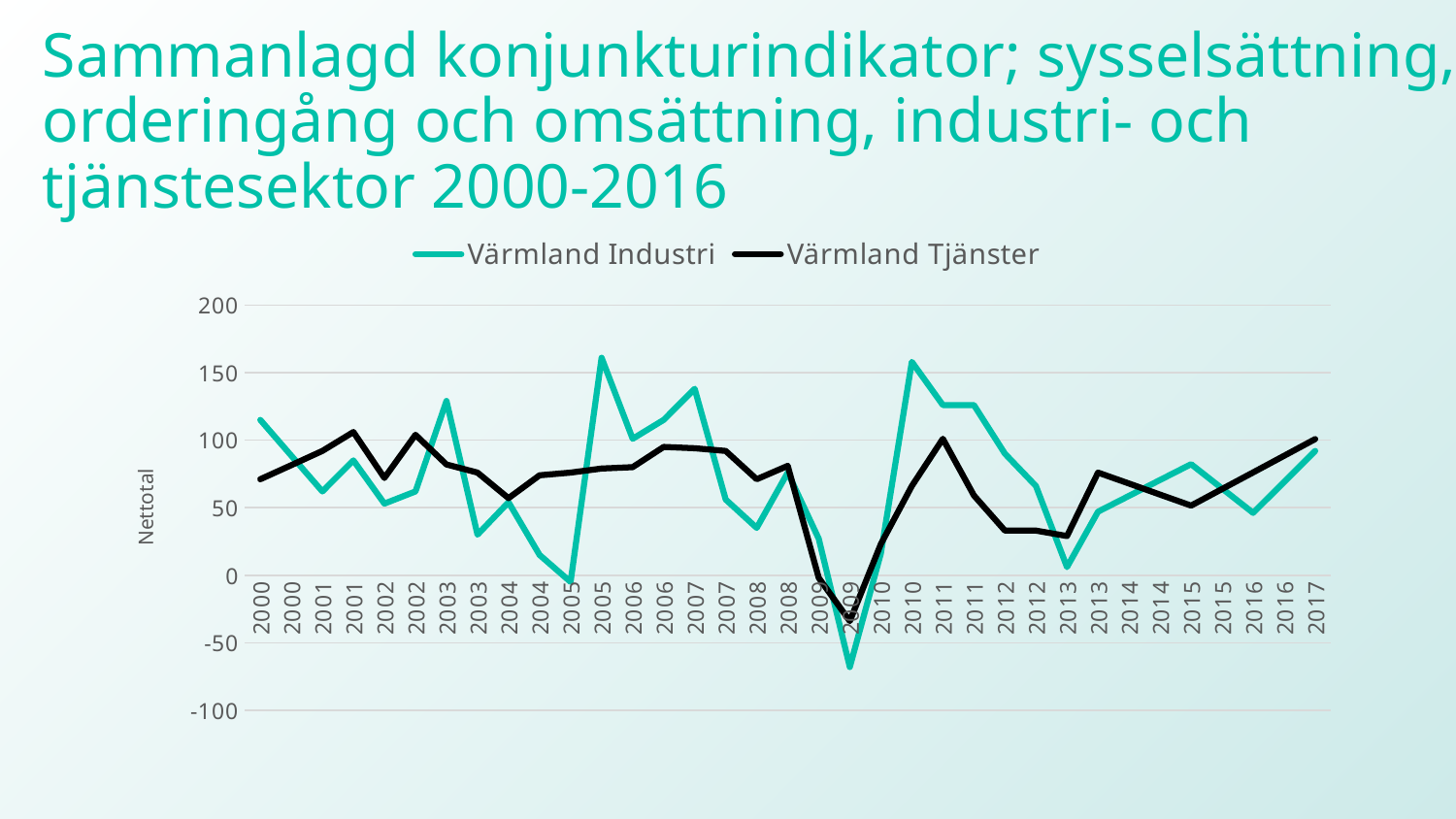
Is the value for Värmland Industri at the second 2009 point greater or less than -50? less How many series does the legend list? 2 In which year does the Värmland Industri series reach its lowest value? 2009 At the second 2004 point, which series has the higher value, Värmland Industri or Värmland Tjänster? Värmland Tjänster What are the two series named in the legend? Värmland Industri and Värmland Tjänster Does the Värmland Tjänster series rise or fall from 2015 to 2017? rise Is the value for Värmland Tjänster at the first 2012 point greater or less than 50? less Is the value for Värmland Tjänster at the second 2009 point greater or less than 0? less At the second 2010 point, which series has the higher value, Värmland Industri or Värmland Tjänster? Värmland Industri What type of chart is shown on the slide? line chart What is the label on the vertical axis? Nettotal